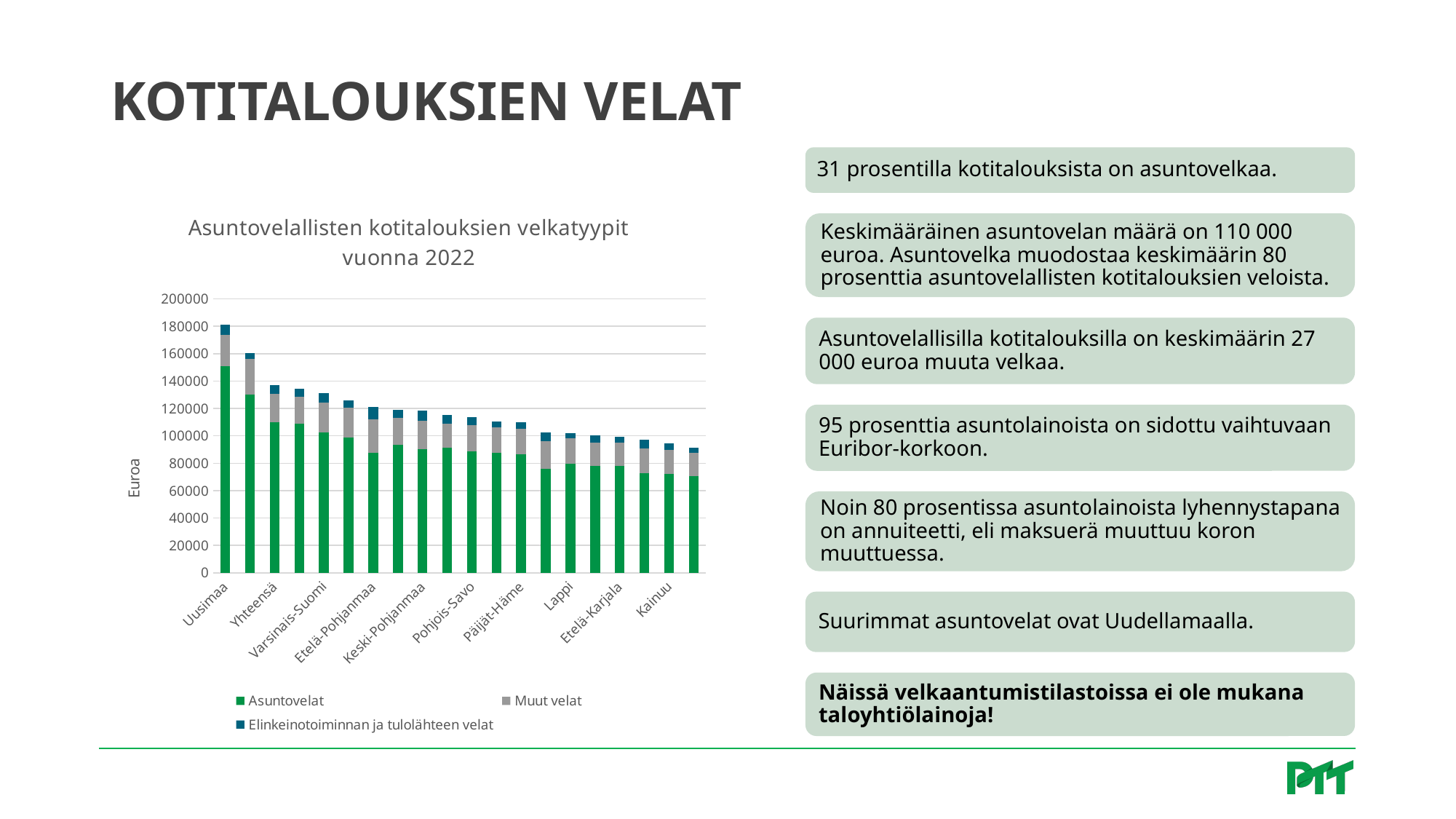
What is the label on the chart's vertical axis? Euroa Do the total bar values rise or fall moving from left to right along the x axis? fall What kind of chart is shown on the slide? stacked bar chart Is the Asuntovelat value for Uusimaa greater or less than 140000? greater What is the title of the chart? Asuntovelallisten kotitalouksien velkatyypit vuonna 2022 How many series does the chart's legend list? 3 Which category has the highest total debt in the chart? Uusimaa Which has a larger total value, Uusimaa or Lappi? Uusimaa Is the total value for Uusimaa greater or less than 160000? greater Which has a larger Asuntovelat value, Yhteensä or Kainuu? Yhteensä Is the total value for Kainuu greater or less than 100000? less